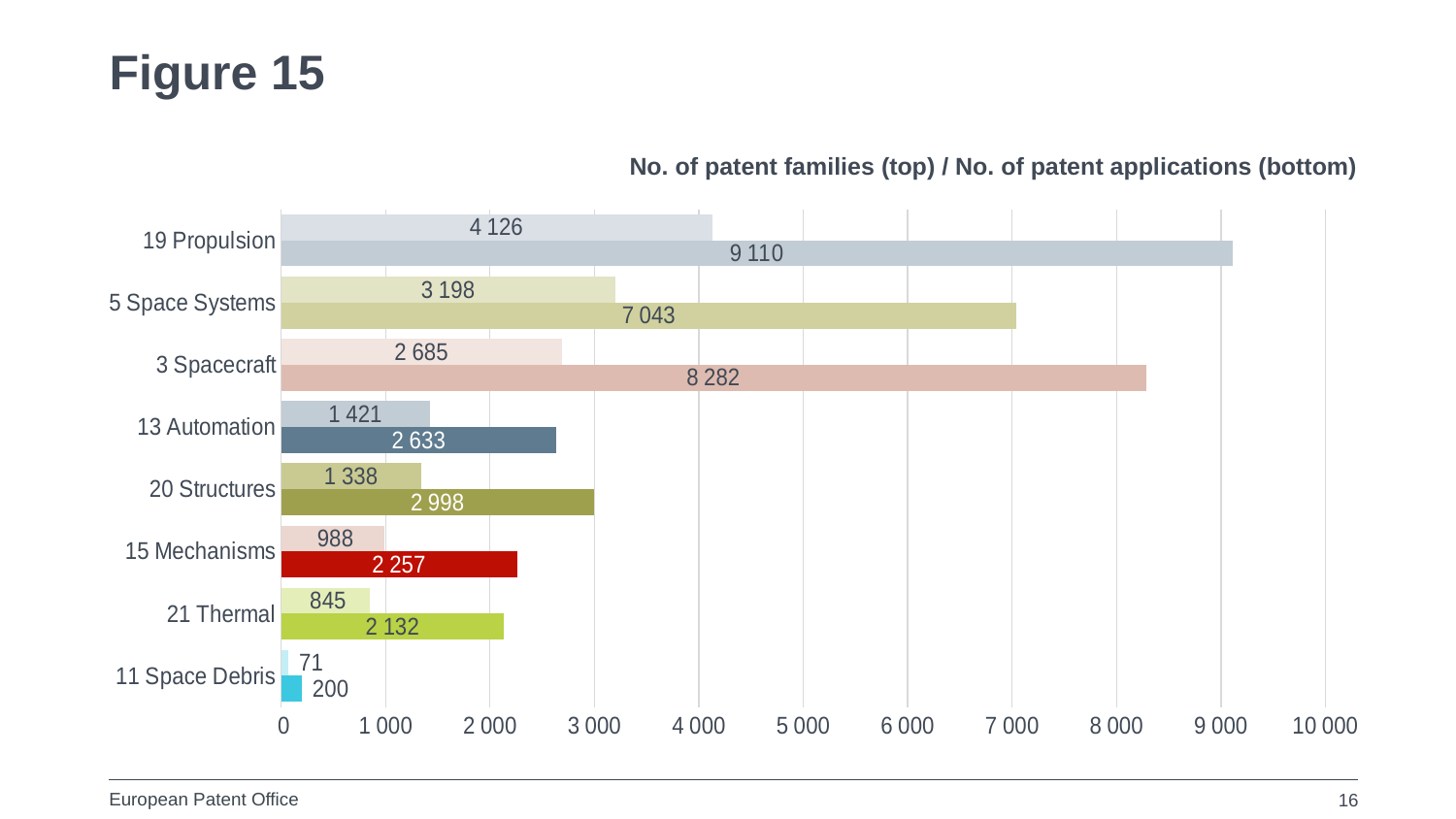
How many categories are shown on the chart? 8 What is the difference between the number of patent applications and the number of patent families for 5 Space Systems? 3 845 Which has more patent applications, 13 Automation or 20 Structures? 20 Structures What kind of chart is shown on the slide? Bar chart Is the number of patent applications for 15 Mechanisms greater or less than 2 000? greater What is the title of the figure on the slide? Figure 15 Which category has the highest number of patent applications? 19 Propulsion Which category has the lowest number of patent families? 11 Space Debris What is the number of patent applications for 3 Spacecraft? 8 282 What is the number of patent families for 19 Propulsion? 4 126 What is the number of patent applications for 21 Thermal? 2 132 What is the difference in the number of patent families between 19 Propulsion and 5 Space Systems? 928